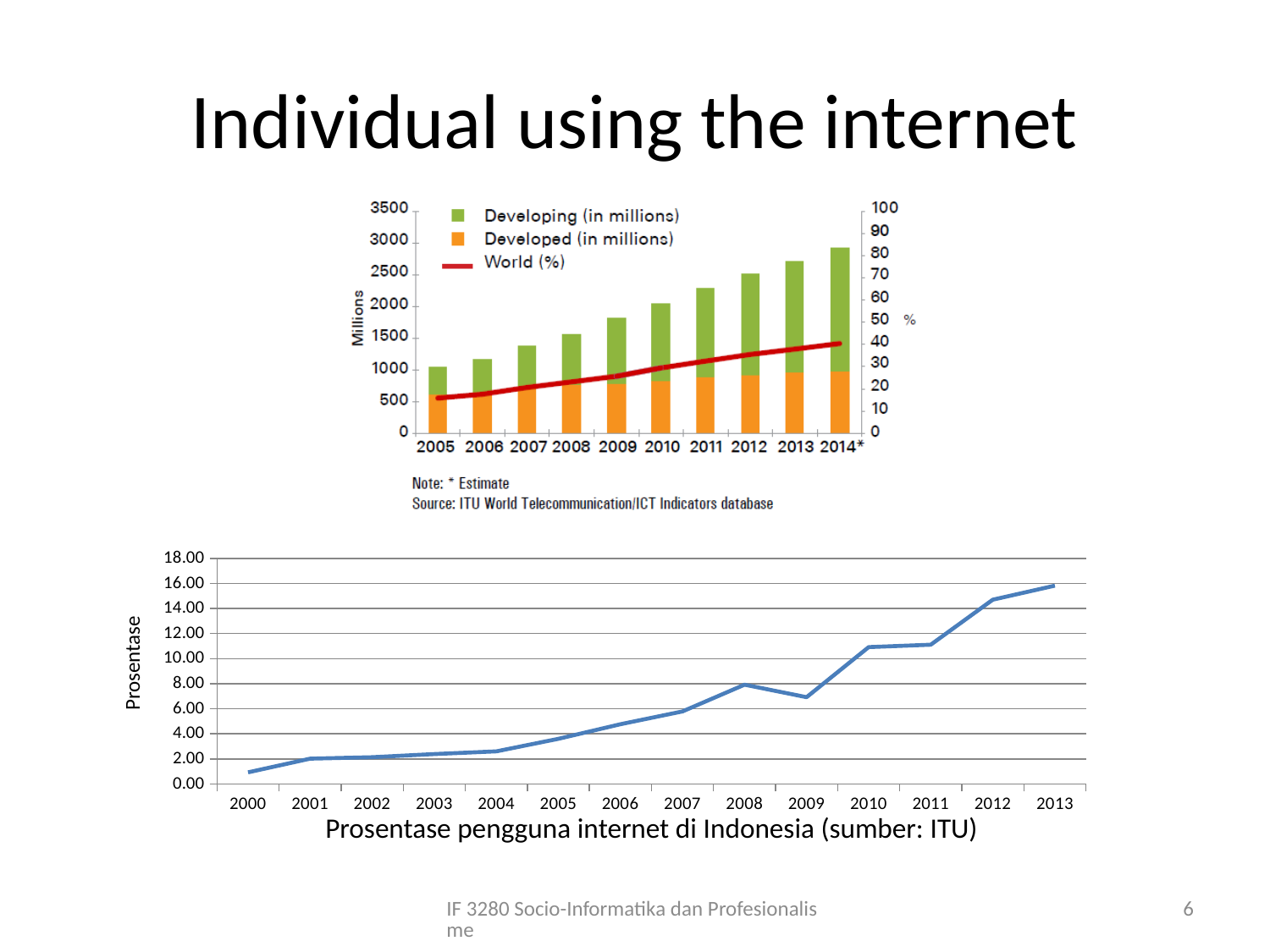
In the bottom chart (Prosentase pengguna internet di Indonesia), which year has the lowest value? 2000 What type of chart is the bottom chart titled 'Prosentase pengguna internet di Indonesia (sumber: ITU)'? line chart In the bottom chart (Prosentase pengguna internet di Indonesia), do the values generally rise or fall from 2000 to 2013? rise How many series does the legend of the top chart list? 3 In the top chart, is the World (%) value for 2005 greater or less than 20? less In the bottom chart (Prosentase pengguna internet di Indonesia), which year has the highest value? 2013 In the top chart, which year has the tallest stacked bar? 2014* How many years are plotted on the x axis of the bottom chart (Prosentase pengguna internet di Indonesia)? 14 In the bottom chart (Prosentase pengguna internet di Indonesia), is the value for 2013 greater or less than 14.00? greater How many years are shown on the x axis of the top chart? 10 In the bottom chart (Prosentase pengguna internet di Indonesia), which year has the larger value, 2008 or 2009? 2008 In the bottom chart (Prosentase pengguna internet di Indonesia), is the value for 2009 greater or less than 8.00? less